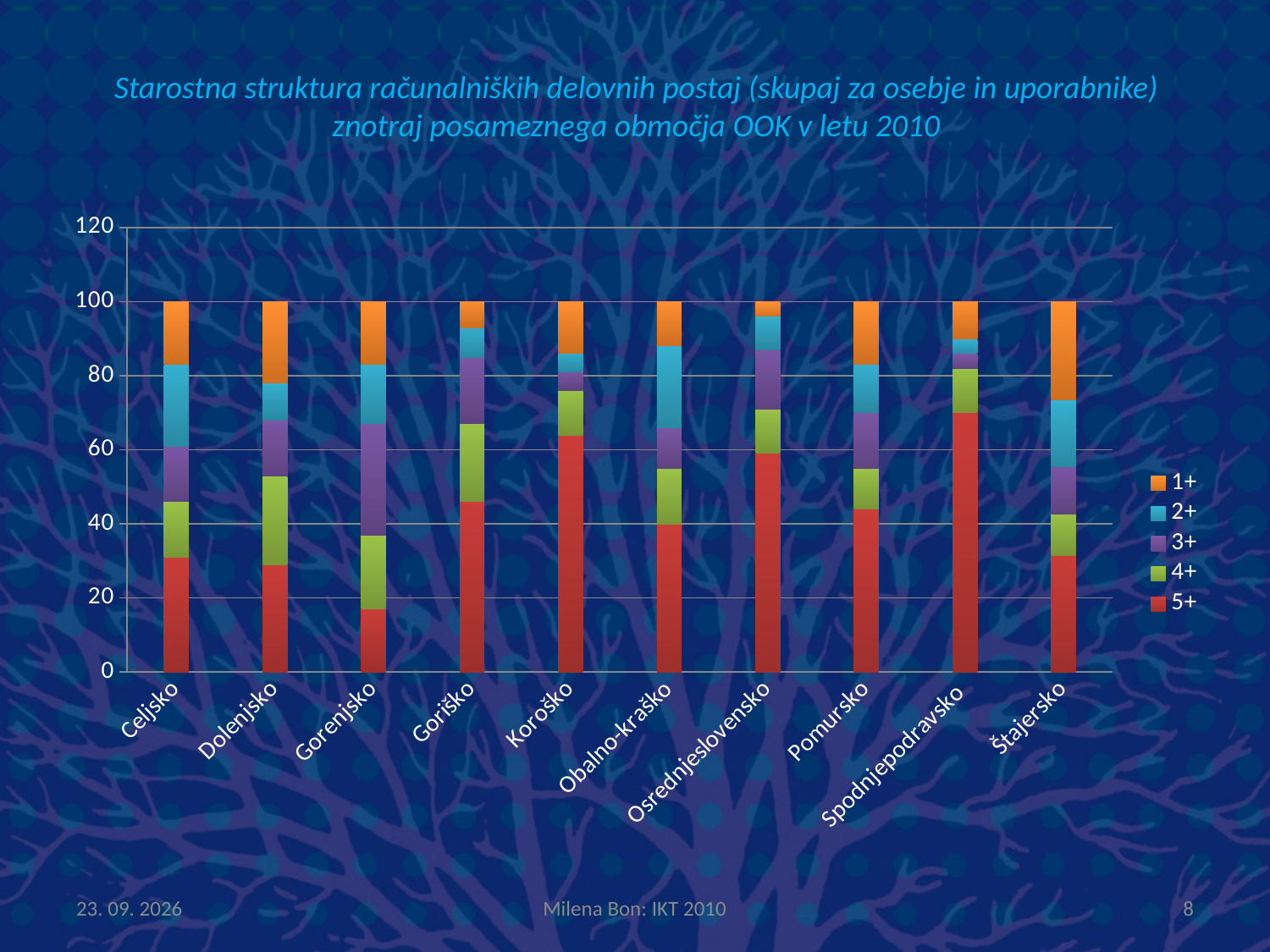
Is the value for the 5+ series in Koroško greater or less than 60? greater How many regions (categories) are shown on the x axis? 10 Which region has the lowest value for the 5+ series? Gorenjsko Is the value for the 5+ series in Gorenjsko greater or less than 20? less What is the highest value shown on the vertical axis? 120 Which series is shown in red at the bottom of each bar? 5+ Which is larger, the 5+ value for Osrednjeslovensko or the 5+ value for Dolenjsko? Osrednjeslovensko What kind of chart is shown on the slide? Stacked bar chart Which region has the highest value for the 5+ series? Spodnjepodravsko Is the value for the 5+ series in Spodnjepodravsko greater or less than 60? greater What is the total height of the stacked bar for Celjsko? 100 How many series does the legend list? 5